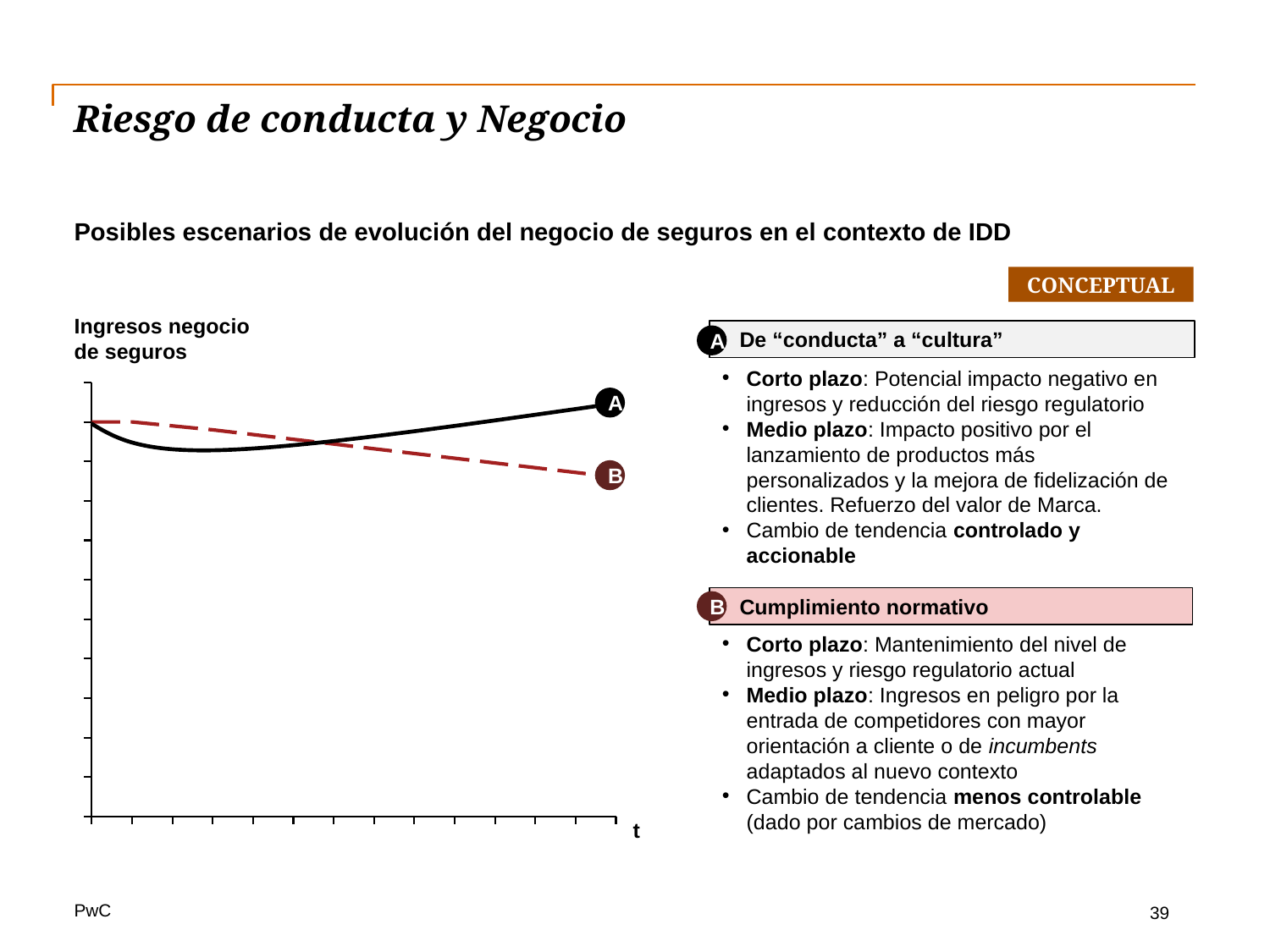
What is the label on the vertical axis of the chart? Ingresos negocio de seguros What is the label on the horizontal axis of the chart? t Does line B rise or fall along the x axis? fall Which line is drawn dashed, A or B? B Which line ends at the lowest point on the chart? B At the right end of the chart, which line is higher, A or B? A How many lines are plotted on the chart? 2 Does line A end higher or lower than where it started? higher What kind of chart is shown on the slide? line chart Which line ends at the highest point on the chart? A